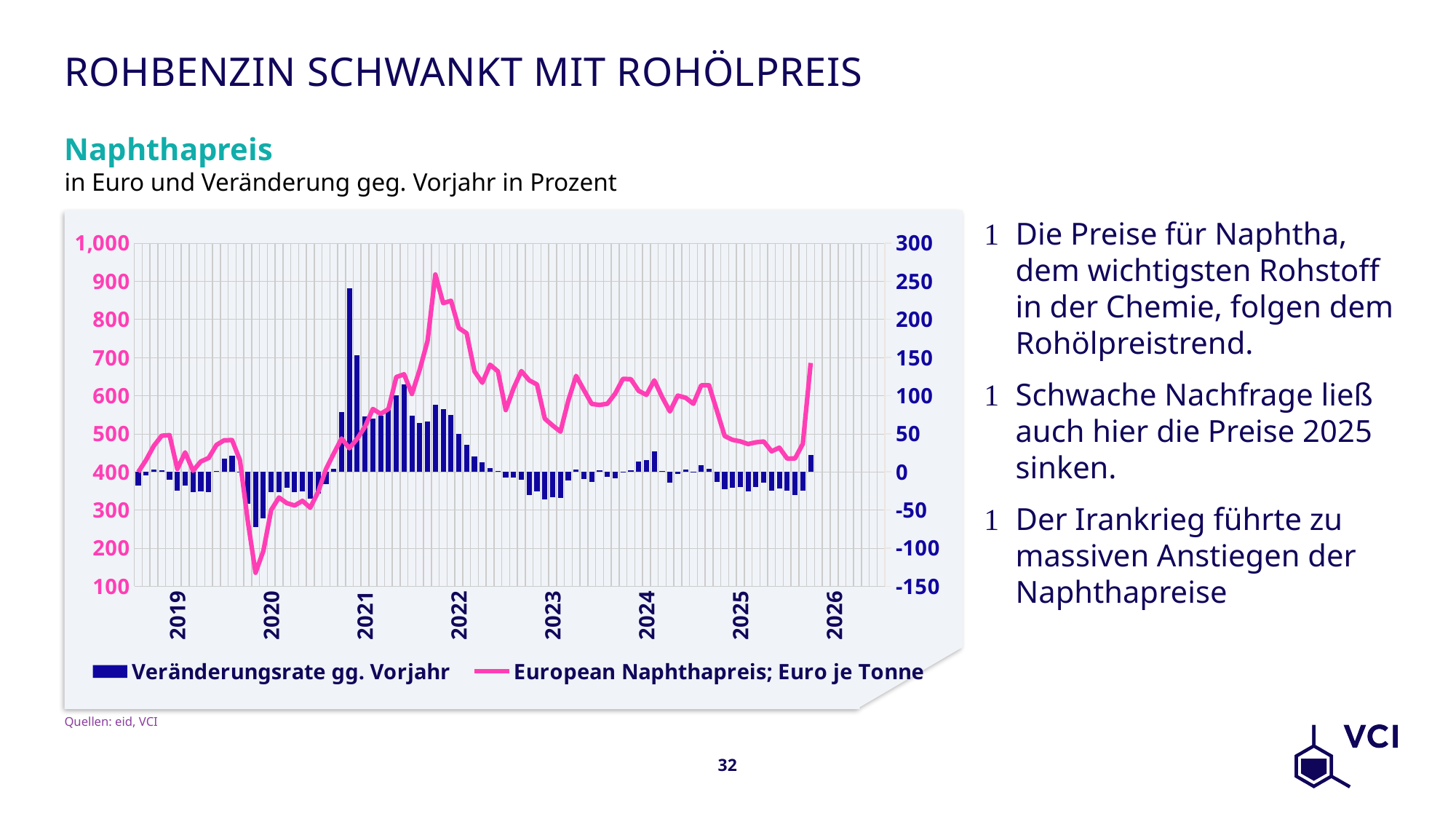
Which is higher, the European Naphthapreis at its peak around the start of 2022 or at its low in 2025? The peak around the start of 2022 Is the lowest Veränderungsrate gg. Vorjahr bar greater or less than -50 on the right axis? less What is the title of the chart? Naphthapreis Is the highest value of the European Naphthapreis line (around the start of 2022) greater or less than 800? greater How many year labels are shown on the x axis? 8 What are the two series named in the chart legend? Veränderungsrate gg. Vorjahr and European Naphthapreis; Euro je Tonne Does the European Naphthapreis line rise or fall between its peak around the start of 2022 and the middle of 2025? fall Is the tallest Veränderungsrate gg. Vorjahr bar greater or less than 200 on the right axis? greater Does the European Naphthapreis line rise or fall at the very end of the series, approaching 2026? rise How many series does the chart legend list? 2 What kind of chart is shown on the slide? A combined bar and line chart